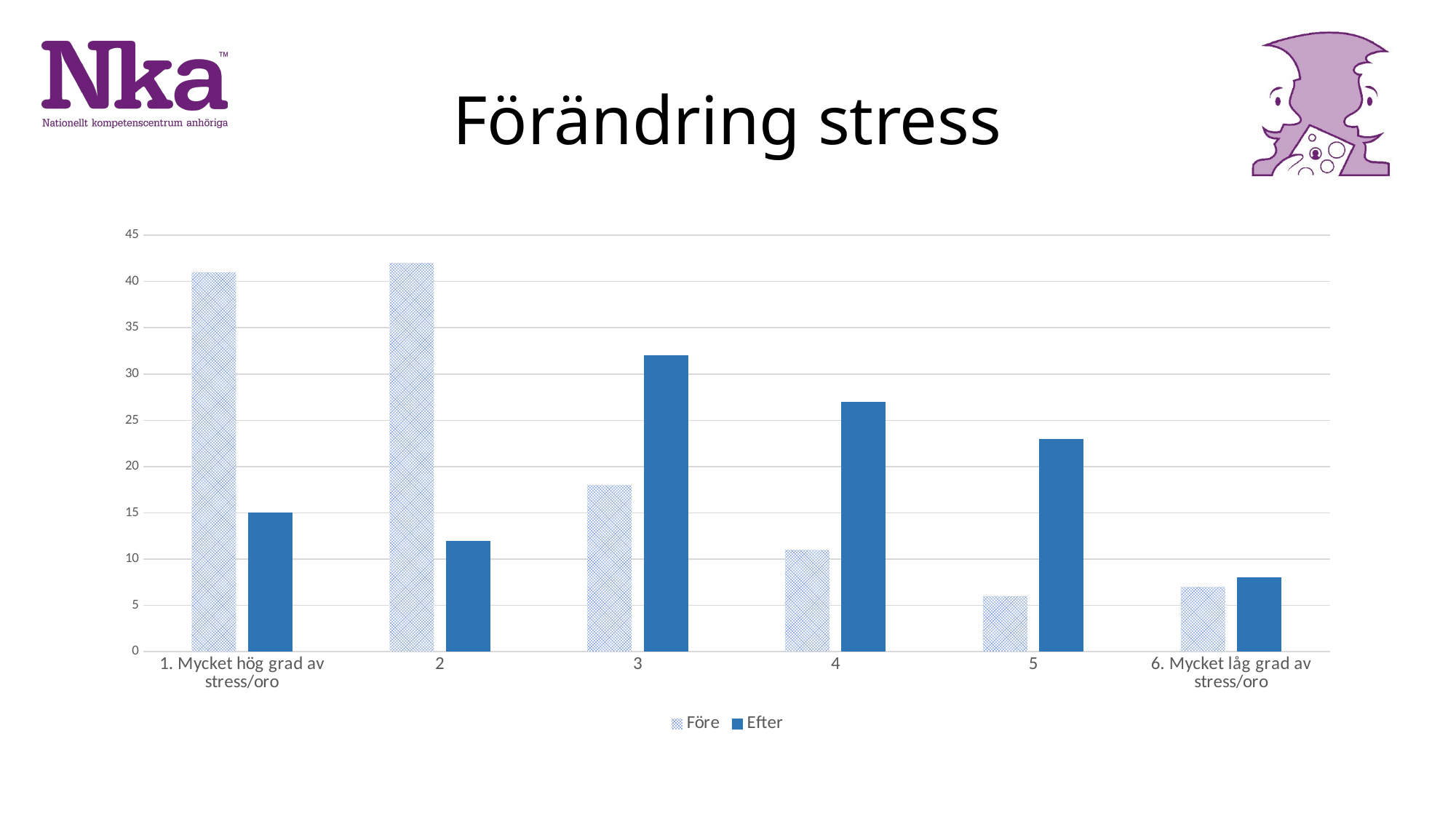
How many series does the legend list? 2 For category 1 (Mycket hög grad av stress/oro), which is larger, Före or Efter? Före How many categories are shown on the x axis? 6 What kind of chart is shown on the slide? bar chart What are the two series named in the legend? Före and Efter Which category has the lowest Efter value? 6. Mycket låg grad av stress/oro Is the Före value for category 2 greater or less than 40? greater Do the Före values generally rise or fall from category 1 to category 6? fall For category 3, which is larger, Före or Efter? Efter What is the title of the chart? Förändring stress Is the Efter value for category 4 greater or less than 25? greater Which category has the highest Efter value? 3